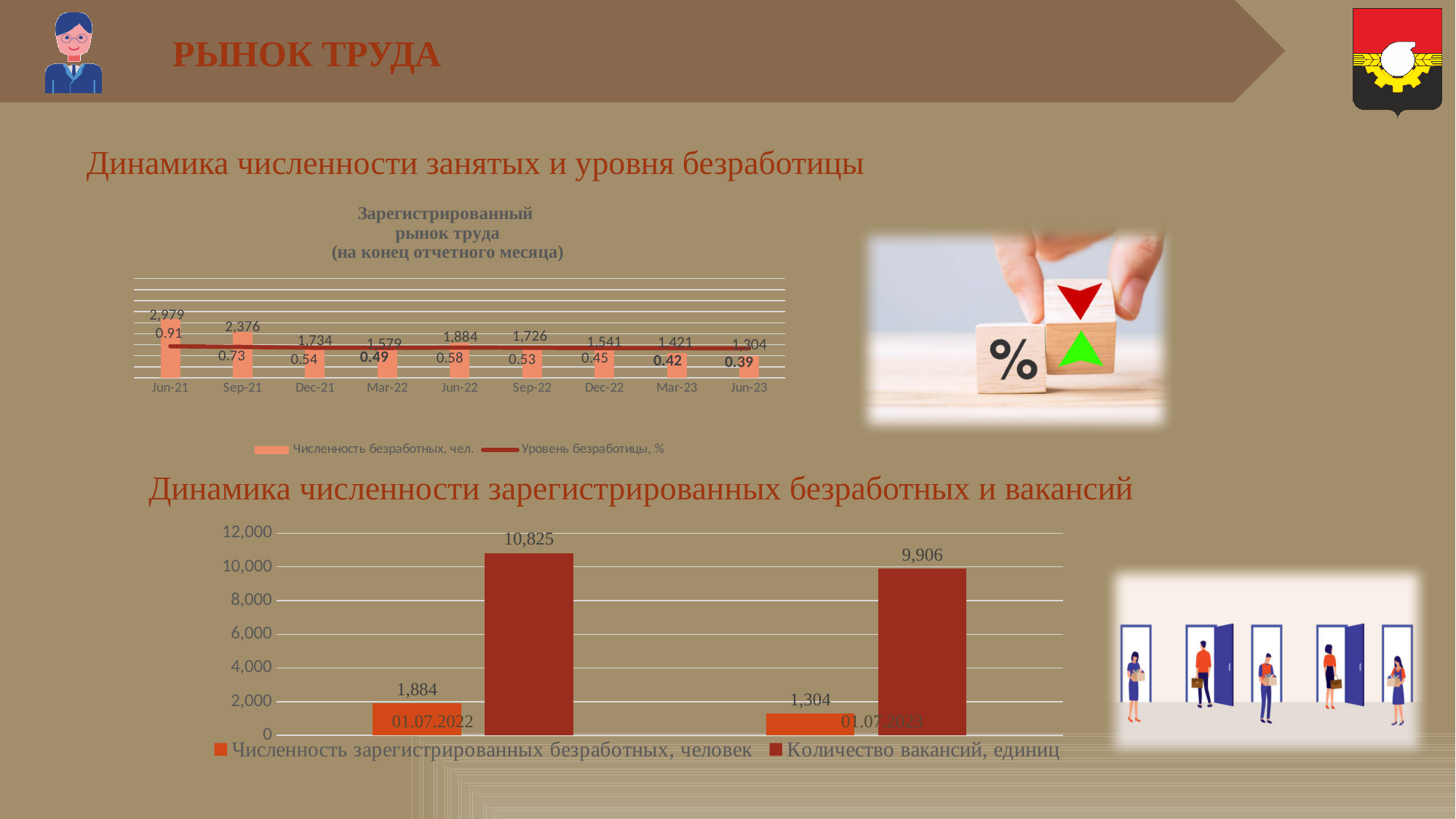
In the bottom chart 'Динамика численности зарегистрированных безработных и вакансий', what is the value of 'Количество вакансий, единиц' for 01.07.2022? 10,825 In the top chart 'Зарегистрированный рынок труда', what is the value of 'Численность безработных, чел.' for Jun-21? 2,979 In the bottom chart 'Динамика численности зарегистрированных безработных и вакансий', how many series does the legend list? 2 In the bottom chart 'Динамика численности зарегистрированных безработных и вакансий', what is the difference in 'Количество вакансий, единиц' between 01.07.2022 and 01.07.2023? 919 In the top chart 'Зарегистрированный рынок труда', which month has the lowest unemployment rate ('Уровень безработицы, %')? Jun-23 In the top chart 'Зарегистрированный рынок труда', does the unemployment rate generally rise or fall from Jun-21 to Jun-23? fall In the top chart 'Зарегистрированный рынок труда', which month has the highest number of unemployed ('Численность безработных, чел.')? Jun-21 In the top chart 'Зарегистрированный рынок труда', what is the value of 'Уровень безработицы, %' for Mar-23? 0.42 In the bottom chart 'Динамика численности зарегистрированных безработных и вакансий', which date has the larger value of 'Численность зарегистрированных безработных, человек'? 01.07.2022 What type of chart is the bottom chart 'Динамика численности зарегистрированных безработных и вакансий'? bar chart In the top chart 'Зарегистрированный рынок труда', how many months are shown on the x axis? 9 In the top chart 'Зарегистрированный рынок труда', what is the difference in 'Численность безработных, чел.' between Jun-22 and Jun-23? 580